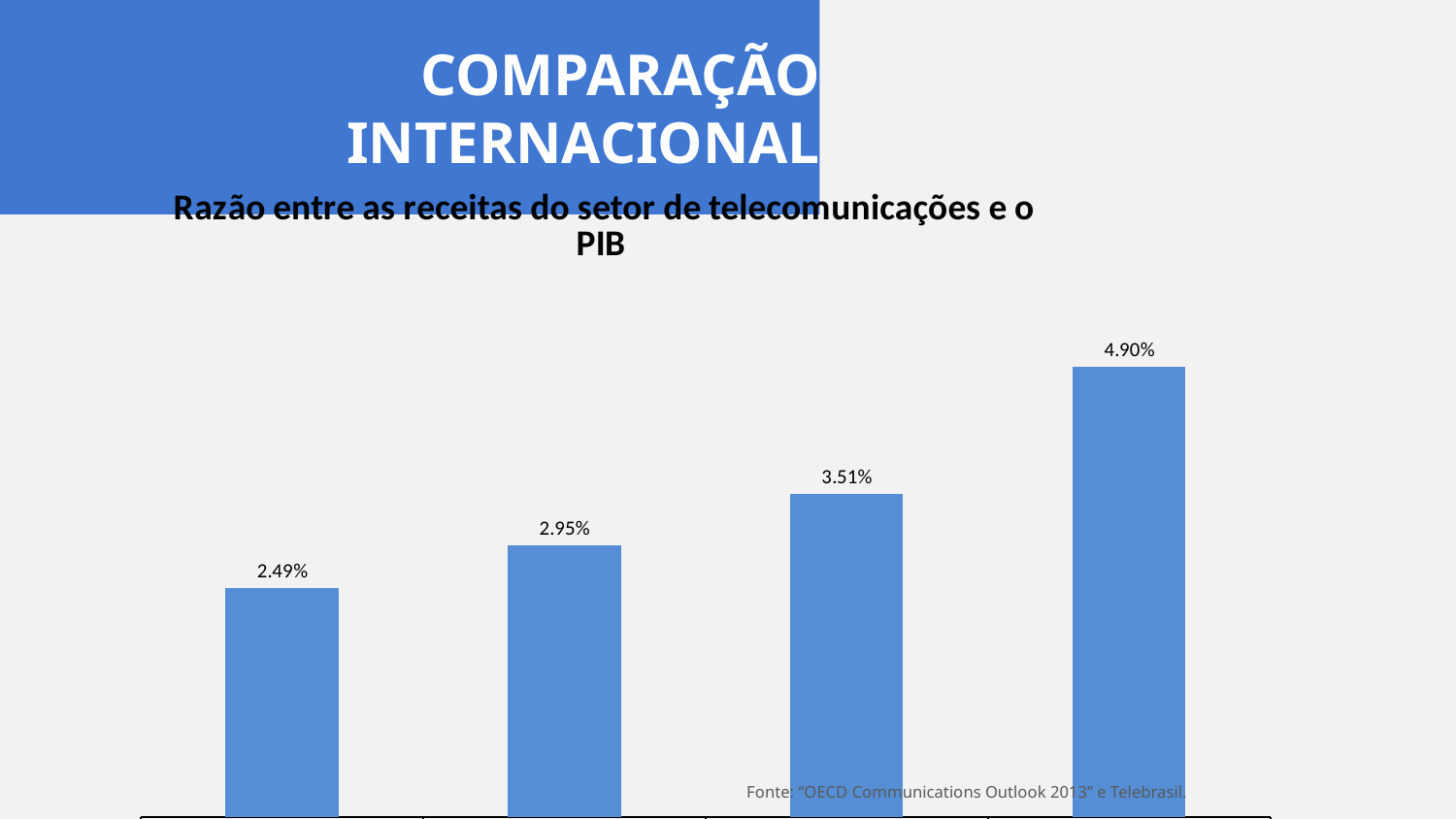
What is the title of the chart? Razão entre as receitas do setor de telecomunicações e o PIB What is the highest value shown in the chart? 4.90% Which is larger, the value of the second bar from the left or the third bar from the left? the third bar from the left (3.51%) Do the bar values rise or fall from left to right across the chart? rise What is the value shown on the third bar from the left? 3.51% What is the value shown on the leftmost bar? 2.49% What is the difference between the rightmost bar (4.90%) and the leftmost bar (2.49%)? 2.41% How many bars are plotted in the chart? 4 What kind of chart is shown on the slide? bar chart What is the value shown on the second bar from the left? 2.95% What is the lowest value shown in the chart? 2.49% What is the value shown on the rightmost bar? 4.90%